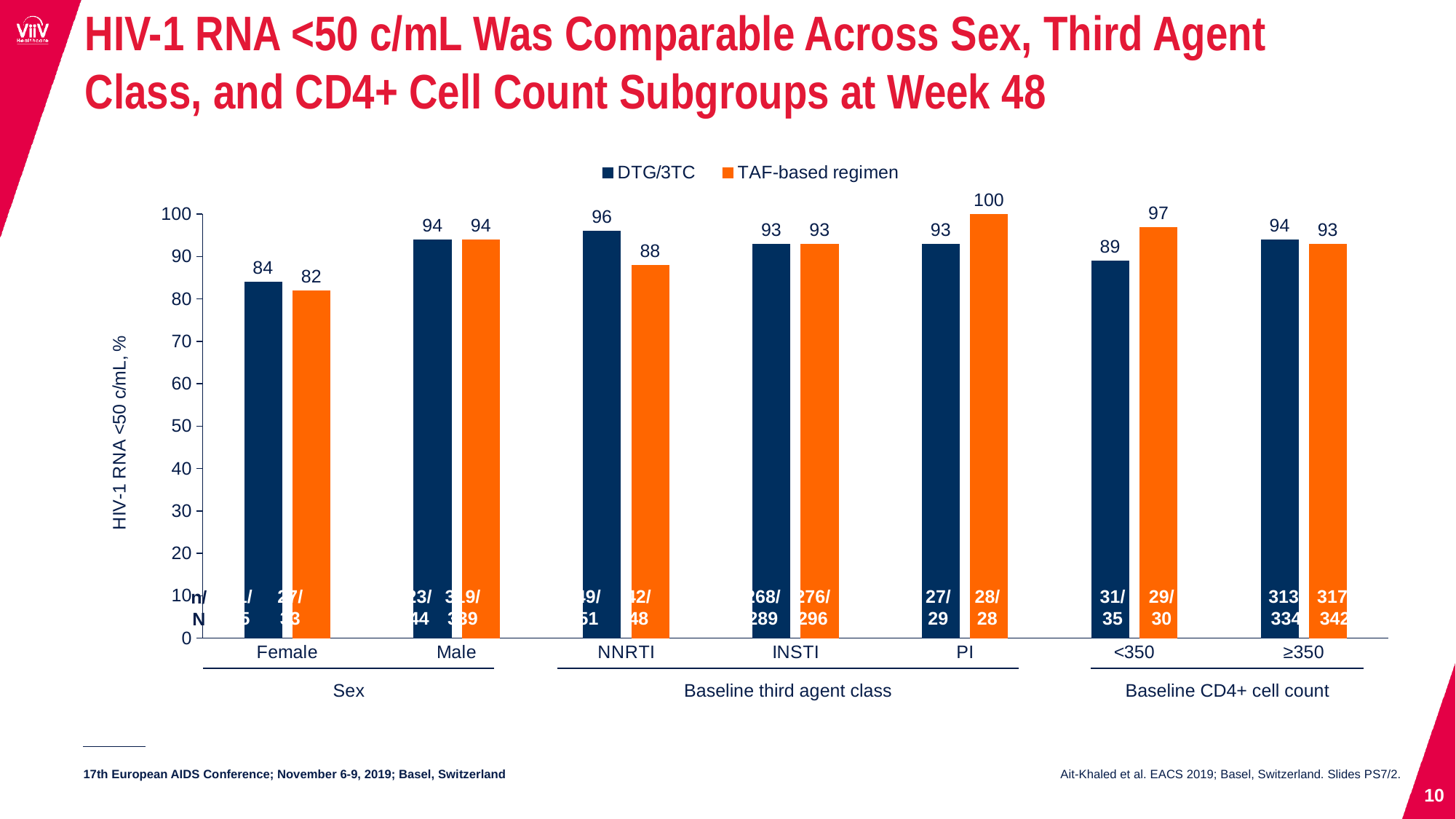
What is the label of the y axis? HIV-1 RNA <50 c/mL, % How many categories are shown on the x axis? 7 What is the value for the TAF-based regimen in the PI category? 100 What is the value for the TAF-based regimen in the <350 category? 97 In the <350 category, which series has the larger value, DTG/3TC or the TAF-based regimen? TAF-based regimen Which category has the highest value for the TAF-based regimen? PI What is the value for DTG/3TC in the NNRTI category? 96 How many series does the legend list? 2 What is the difference between the DTG/3TC and TAF-based regimen values in the NNRTI category? 8 Which category has the lowest value for DTG/3TC? Female What kind of chart is shown on the slide? Bar chart What is the value for DTG/3TC in the Female category? 84